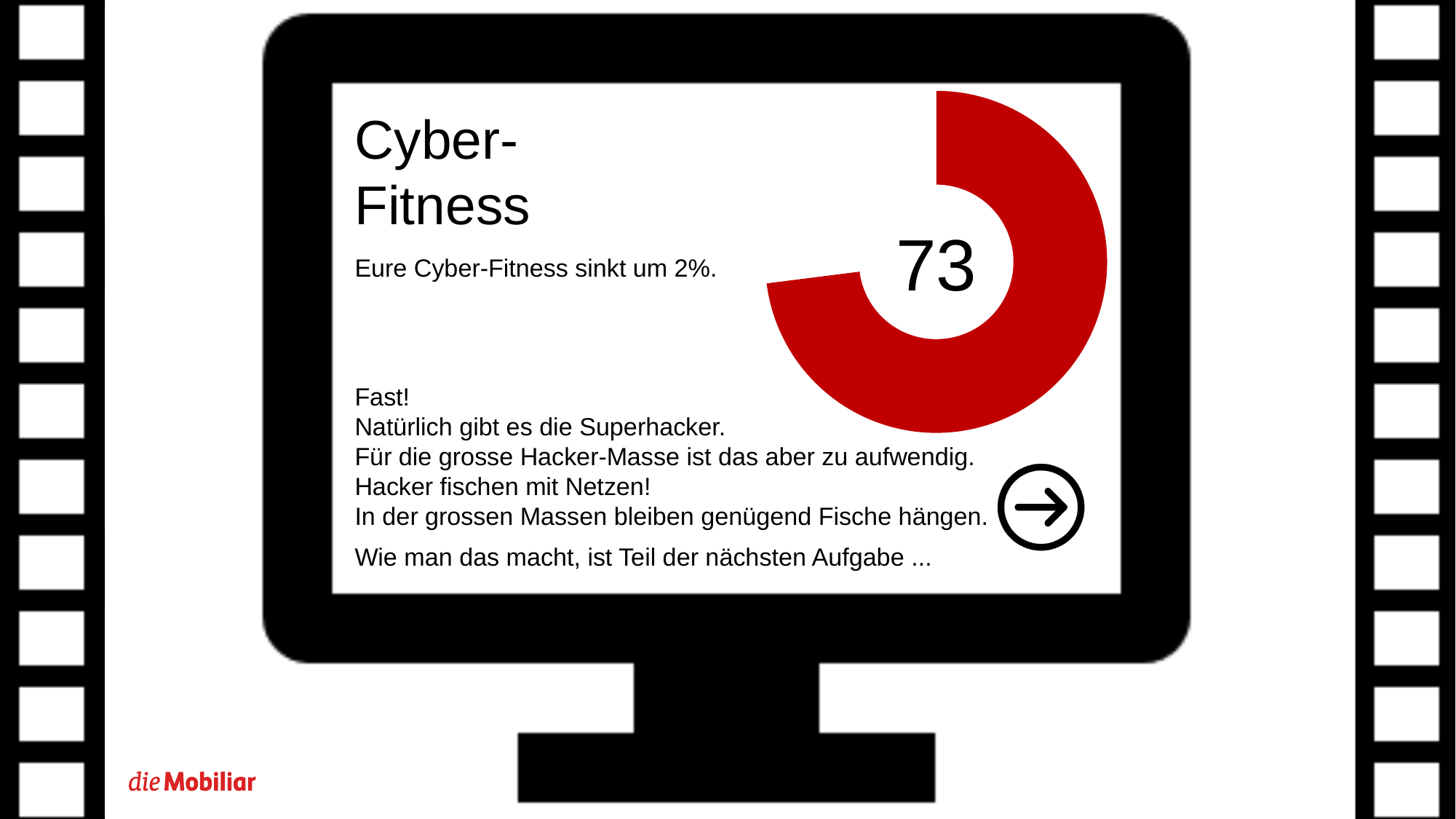
Is the value shown in the doughnut chart greater or less than 100? less Does the filled red arc cover more or less than half of the doughnut chart? more What colour is the filled arc of the doughnut chart? Red What kind of chart is shown on the slide? Doughnut chart According to the text next to the chart, by how much does the Cyber-Fitness sink? 2% Is the value shown in the doughnut chart greater or less than 50? greater What is the Cyber-Fitness score shown in the doughnut chart? 73 What number is displayed in the centre of the doughnut chart? 73